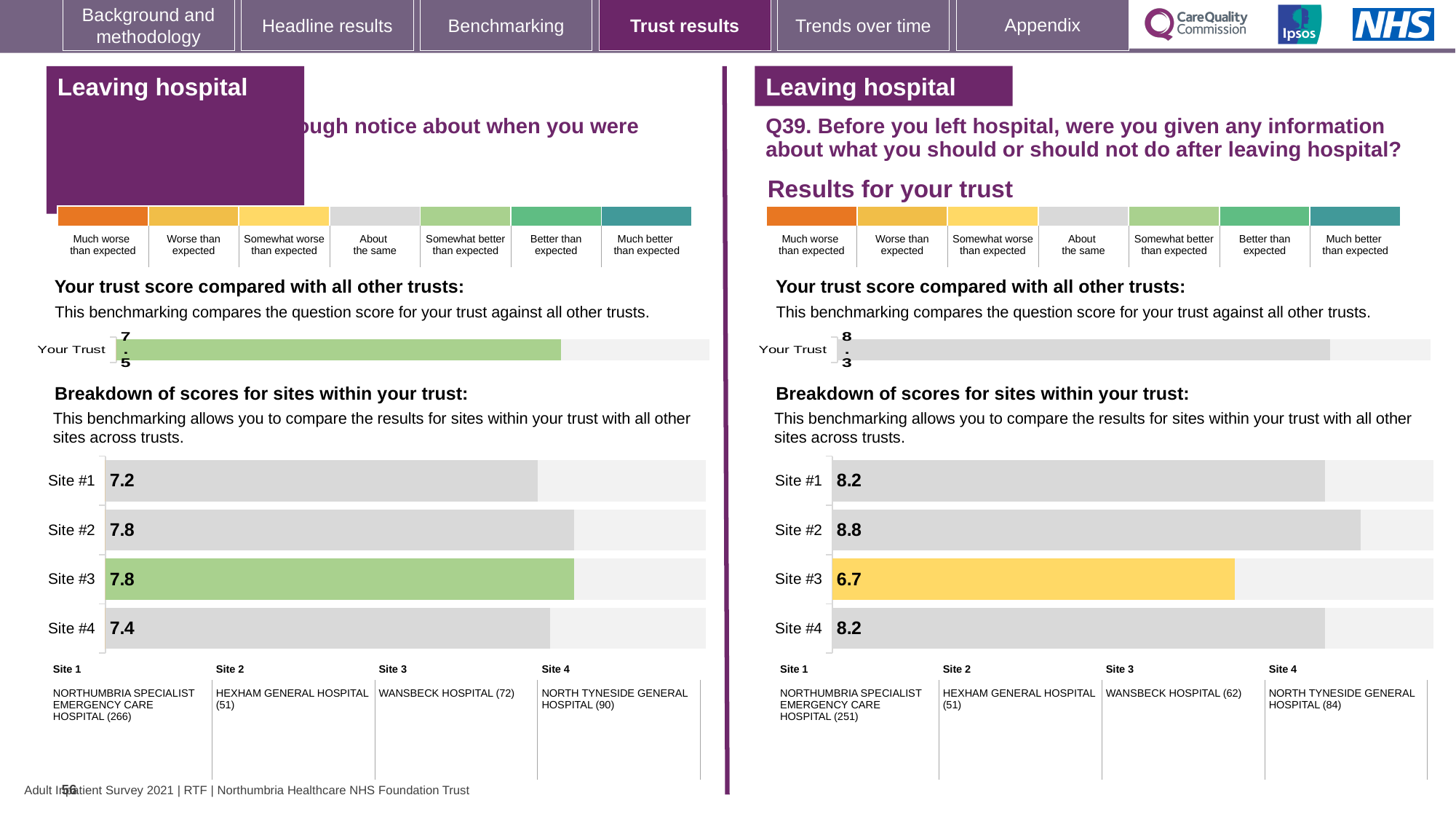
On the left-hand site breakdown chart, what is the difference between the scores for Site #2 and Site #1? 0.6 On the left-hand site breakdown chart, which is larger, the score for Site #4 or the score for Site #1? Site #4 On the right-hand (Q39) site breakdown chart, what is the score for Site #2? 8.8 On the left-hand site breakdown chart, what is the score for Site #1? 7.2 On the left-hand site breakdown chart, what is the score for Site #4? 7.4 On the left-hand site breakdown chart, which site has the lowest score? Site #1 On the right-hand (Q39) site breakdown chart, what is the score for Site #3? 6.7 On the right-hand (Q39) site breakdown chart, which site has the highest score? Site #2 On the right-hand (Q39) site breakdown chart, which site has the lowest score? Site #3 What type of chart is used for the site breakdown on the left-hand side of the slide? Bar chart How many sites are shown on the right-hand (Q39) site breakdown chart? 4 On the right-hand (Q39) site breakdown chart, what is the difference between the scores for Site #2 and Site #3? 2.1